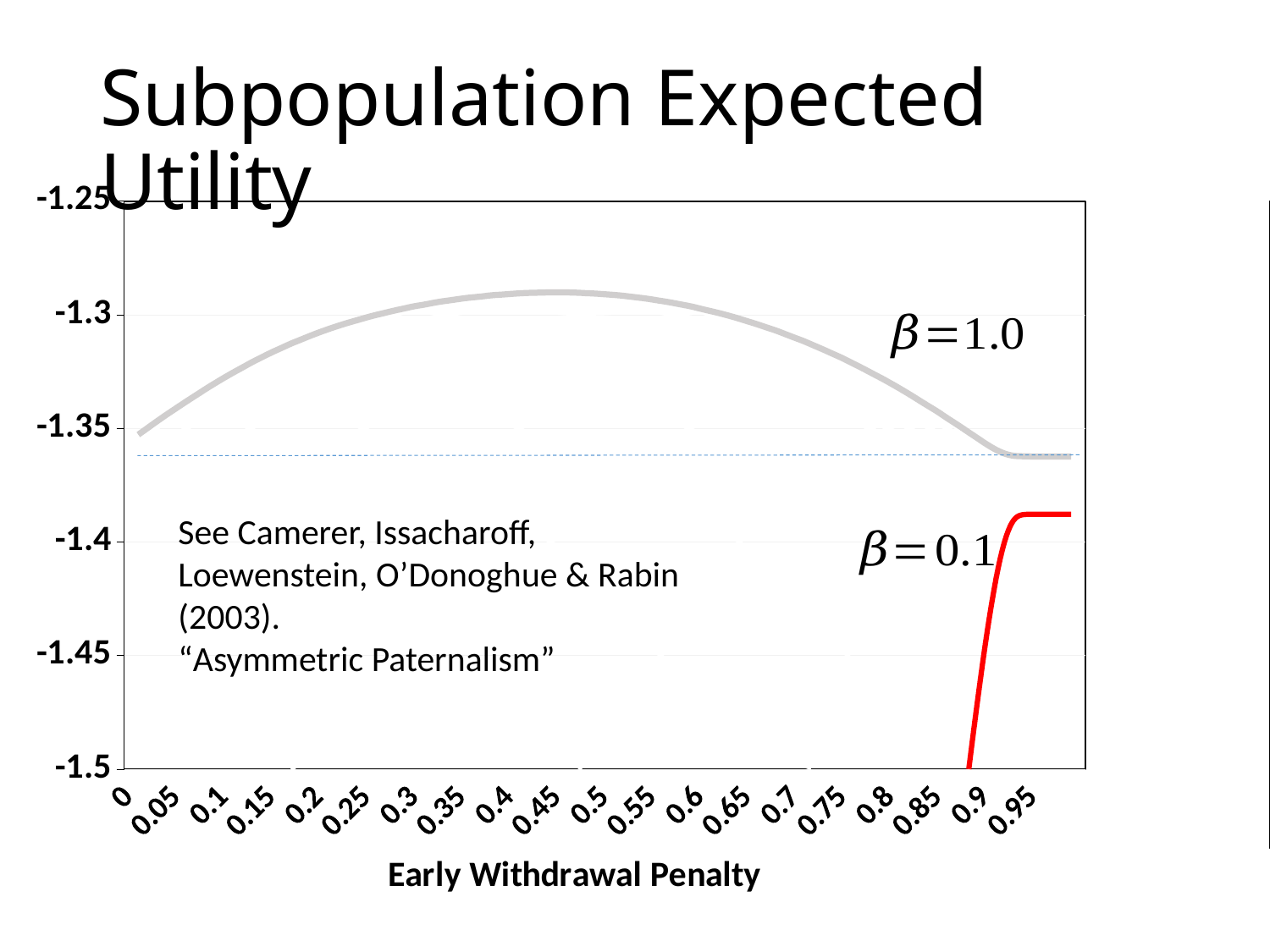
Does the β=1.0 curve rise or fall as the early withdrawal penalty increases from 0 to 0.4? rise Is the peak value of the β=1.0 curve greater or less than -1.3? greater What is the lowest value shown on the y axis? -1.5 What is the highest value shown on the y axis? -1.25 What kind of chart is shown on the slide? line chart What is the title of the chart? Subpopulation Expected Utility What is the label of the x axis? Early Withdrawal Penalty How many tick labels are shown on the x axis? 20 Is the value of the β=1.0 curve at an early withdrawal penalty of 0.95 greater or less than -1.4? greater At an early withdrawal penalty of 0.95, which curve has the higher expected utility, β=1.0 or β=0.1? β=1.0 Is the value of the β=0.1 curve at an early withdrawal penalty of 0.95 greater or less than -1.4? greater Does the β=1.0 curve rise or fall as the early withdrawal penalty increases from 0.6 to 0.9? fall